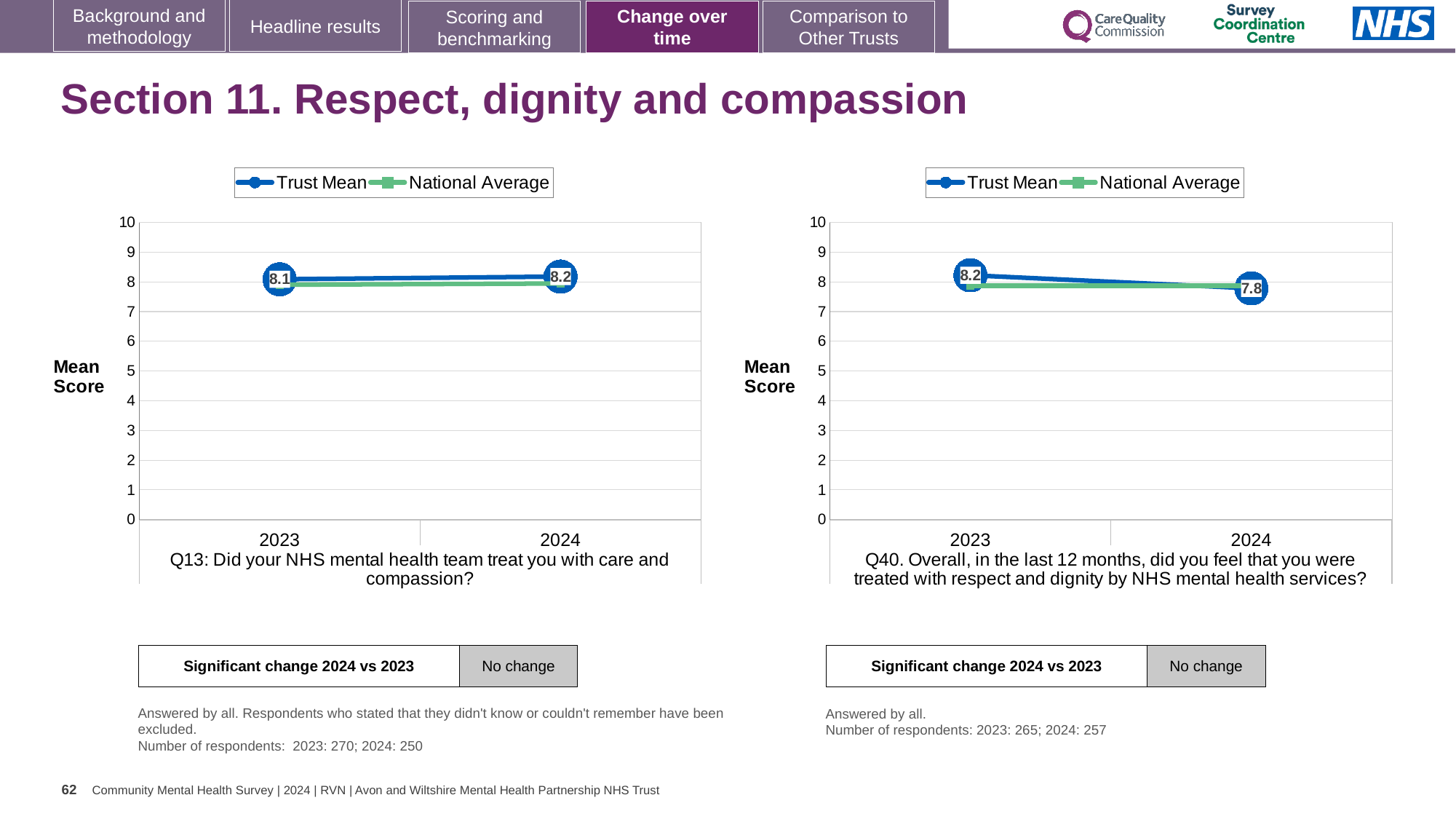
In the left chart (Q13), which year has the higher Trust Mean score, 2023 or 2024? 2024 In the right chart (Q40), does the Trust Mean rise or fall from 2023 to 2024? fall What kind of chart is the left chart (Q13)? line chart In the right chart (Q40), by how much did the Trust Mean score fall from 2023 to 2024? 0.4 In the right chart (Q40), what is the Trust Mean score for 2024? 7.8 In the right chart (Q40), is the Trust Mean score for 2024 greater or less than 5? greater In the left chart (Q13), what is the Trust Mean score for 2023? 8.1 How many series does the legend of the right chart (Q40) list? 2 In the left chart (Q13), what is the difference between the Trust Mean scores for 2024 and 2023? 0.1 In the right chart (Q40), what is the Trust Mean score for 2023? 8.2 In the left chart (Q13), what is the Trust Mean score for 2024? 8.2 How many years are plotted on the x axis of the left chart (Q13)? 2